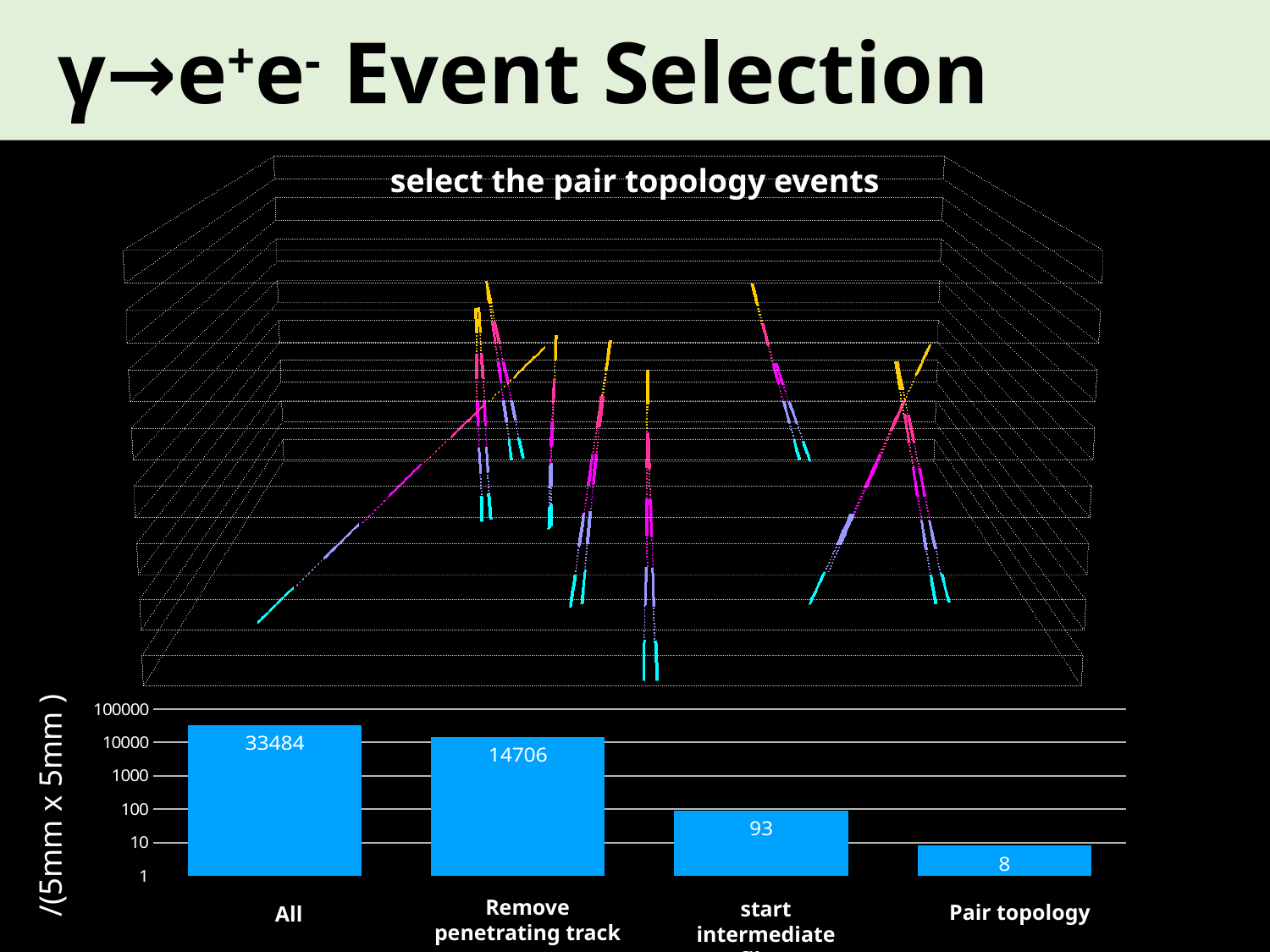
Which category has the highest value? All How many bars are in the chart? 4 What is the value of the bar for "Remove penetrating track"? 14706 What kind of chart is shown at the bottom of the slide? bar chart What is the value of the bar for "All"? 33484 Which is larger, the value for "Remove penetrating track" or the value for "Pair topology"? Remove penetrating track What is the value of the bar for "Pair topology"? 8 Is the value for "Pair topology" greater or less than 10? less Which category has the lowest value? Pair topology What is the value of the third bar from the left? 93 What is the difference between the values for "All" and "Remove penetrating track"? 18778 Do the bar values rise or fall from left to right? fall